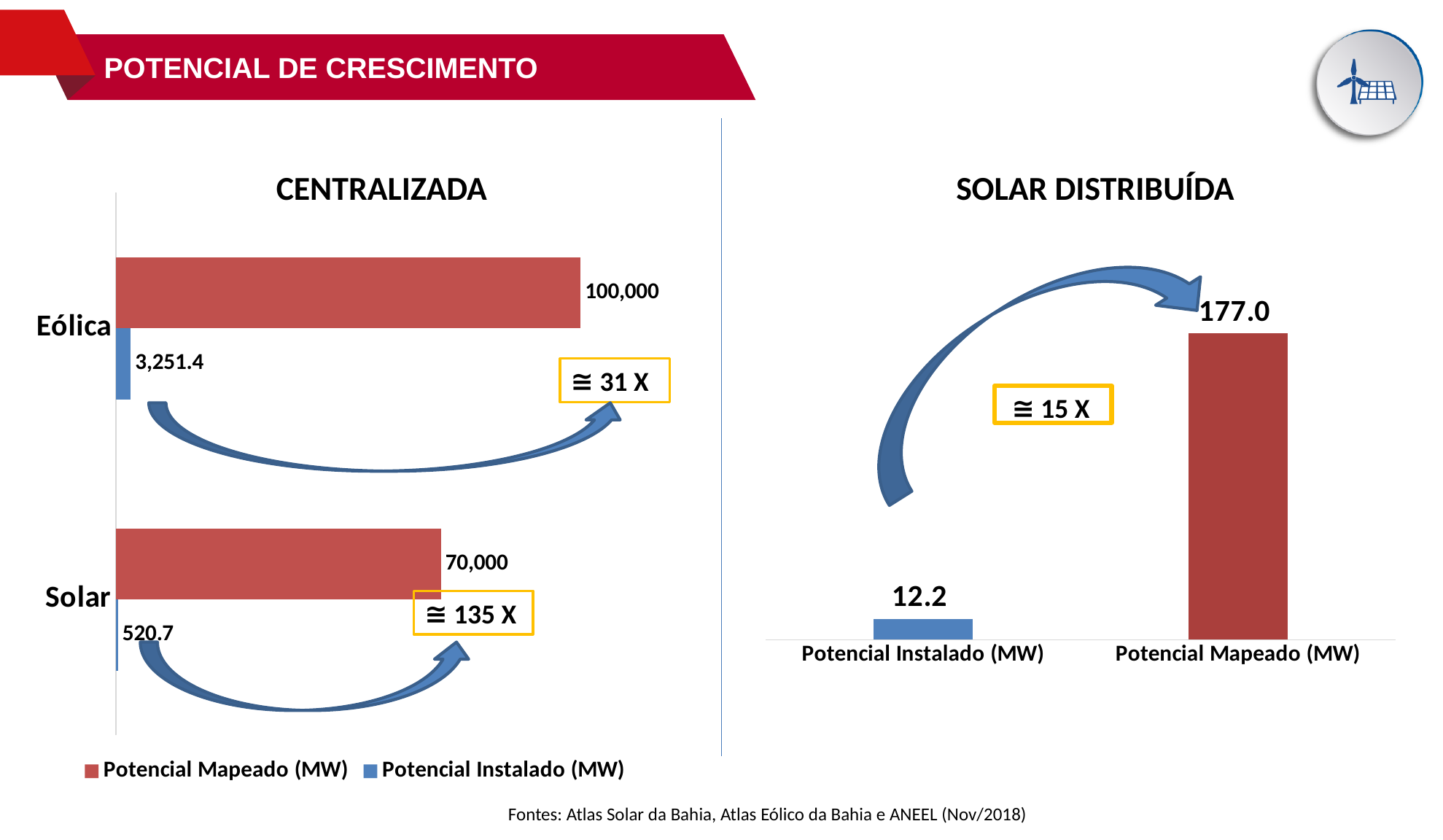
In the CENTRALIZADA chart, which category has the lowest Potencial Mapeado (MW)? Solar How many categories are shown in the SOLAR DISTRIBUÍDA chart? 2 In the SOLAR DISTRIBUÍDA chart, what is the value for Potencial Instalado (MW)? 12.2 In the SOLAR DISTRIBUÍDA chart, what is the value for Potencial Mapeado (MW)? 177.0 In the SOLAR DISTRIBUÍDA chart, what is the difference between Potencial Mapeado (MW) and Potencial Instalado (MW)? 164.8 In the CENTRALIZADA chart, what is the Potencial Instalado (MW) value for Eólica? 3,251.4 How many series does the legend of the CENTRALIZADA chart list? 2 In the CENTRALIZADA chart, what is the Potencial Mapeado (MW) value for Eólica? 100,000 In the CENTRALIZADA chart, which category has the higher Potencial Instalado (MW), Eólica or Solar? Eólica What kind of chart is the CENTRALIZADA chart? Bar chart In the CENTRALIZADA chart, what is the Potencial Instalado (MW) value for Solar? 520.7 In the CENTRALIZADA chart, what is the difference between the Potencial Mapeado (MW) values for Eólica and Solar? 30,000